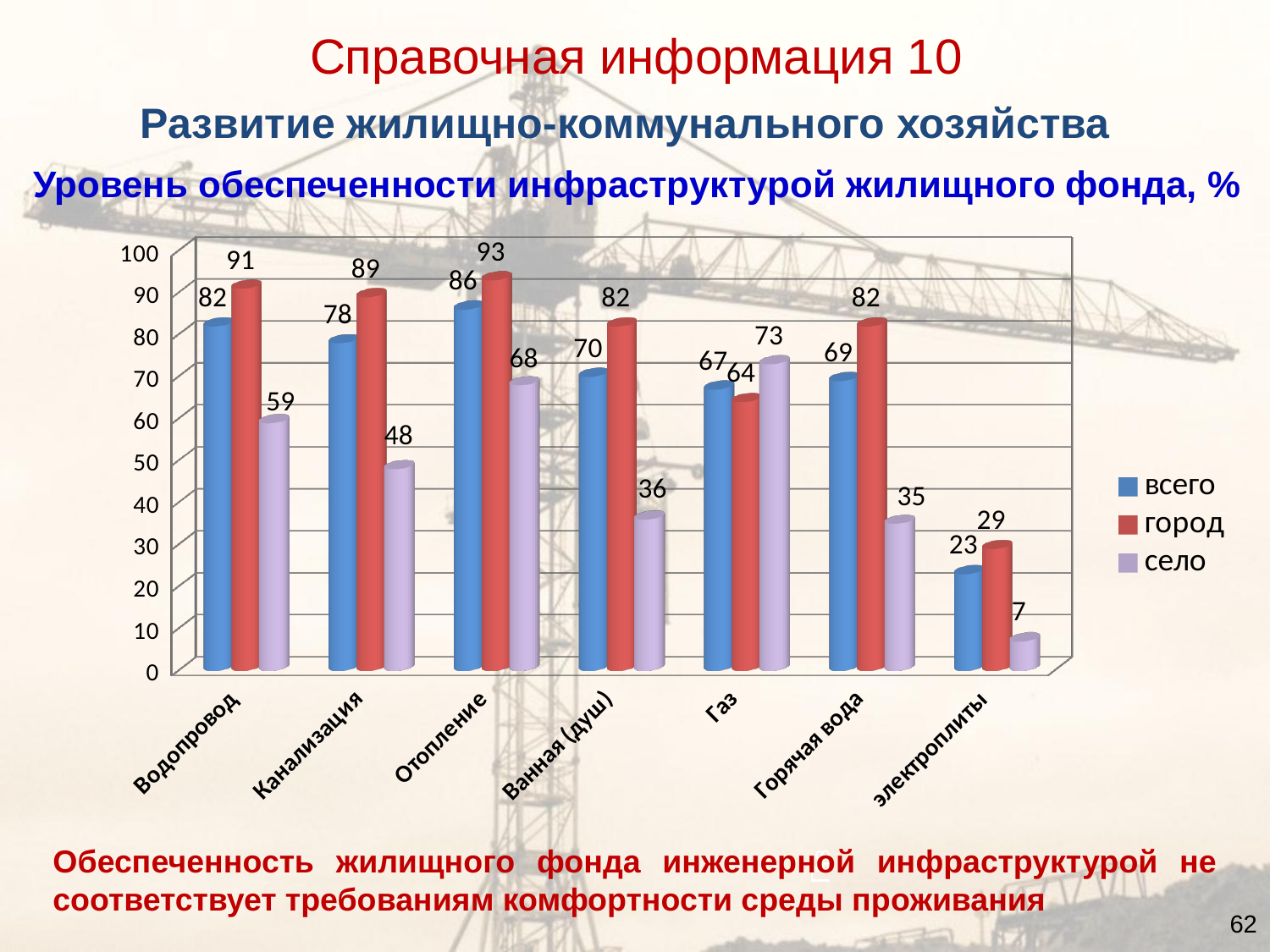
What is the value for "село" in the "Канализация" category? 48 What is the value for "всего" in the "Горячая вода" category? 69 Which category has the highest value for the "город" series? Отопление How many categories are shown on the x axis? 7 What is the difference between the "город" and "село" values in the "Ванная (душ)" category? 46 What is the value for "город" in the "Водопровод" category? 91 How many series does the legend list? 3 In the "Газ" category, which series has the larger value: "город" or "село"? село What colour are the bars for the "село" series? purple What is the value for "всего" in the "электроплиты" category? 23 Which category has the lowest value for the "село" series? электроплиты What kind of chart is shown on the slide? bar chart